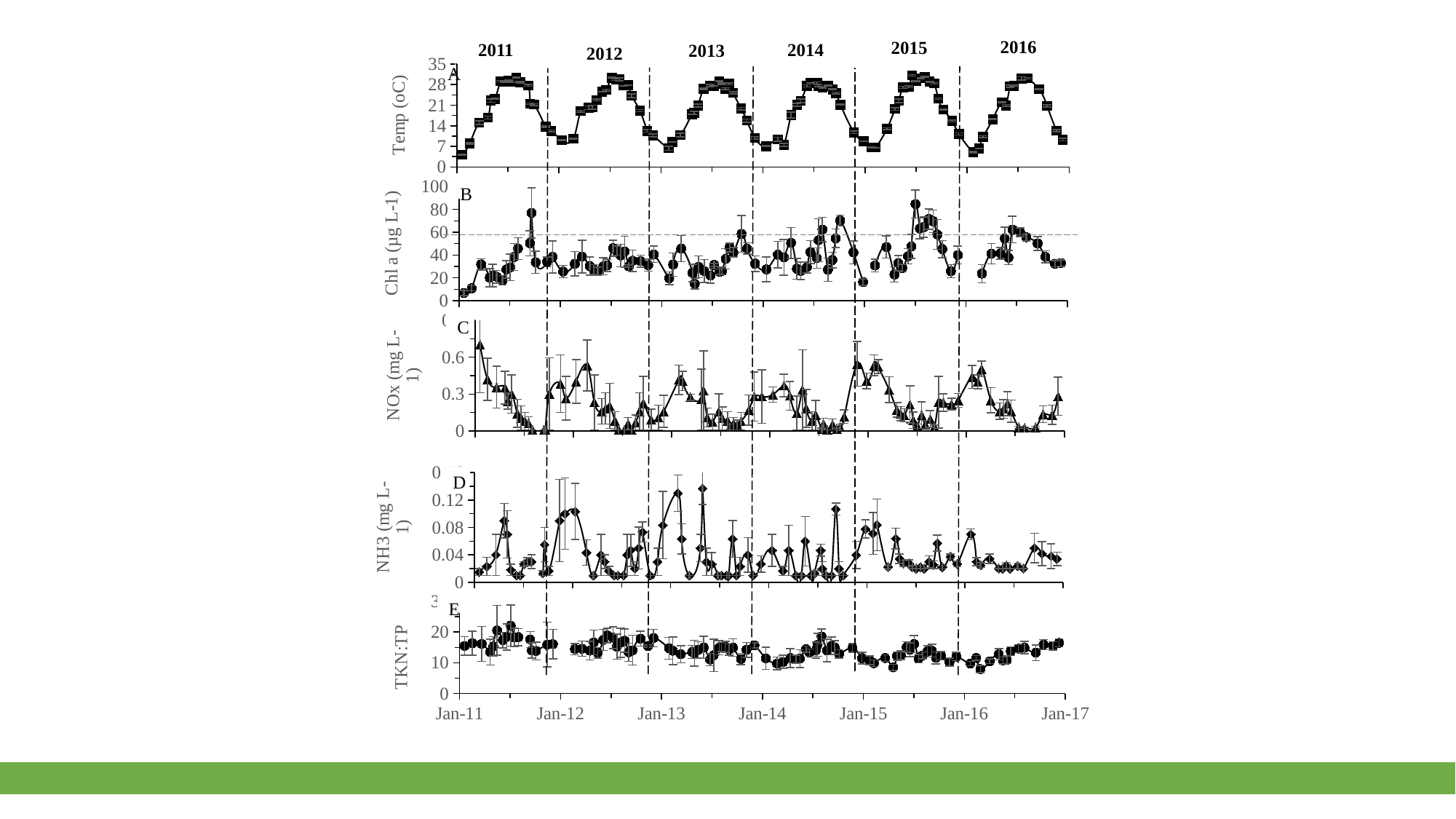
How many panels (A through E) are stacked on the slide? 5 In panel A, does the temperature rise or fall from Jan-11 to mid-2011? rise What kind of chart is shown in panel A (Temp)? line chart What is the y-axis label of panel B? Chl a (µg L-1) In panel A, is the lowest temperature in early 2016 greater or less than 14? less In panel B, is the highest Chl a value in 2015 greater or less than 60? greater In panel A, is the peak temperature in summer 2015 greater or less than 21? greater How many years are labelled across the top of the chart? 6 What is the y-axis label of the bottom panel (E)? TKN:TP